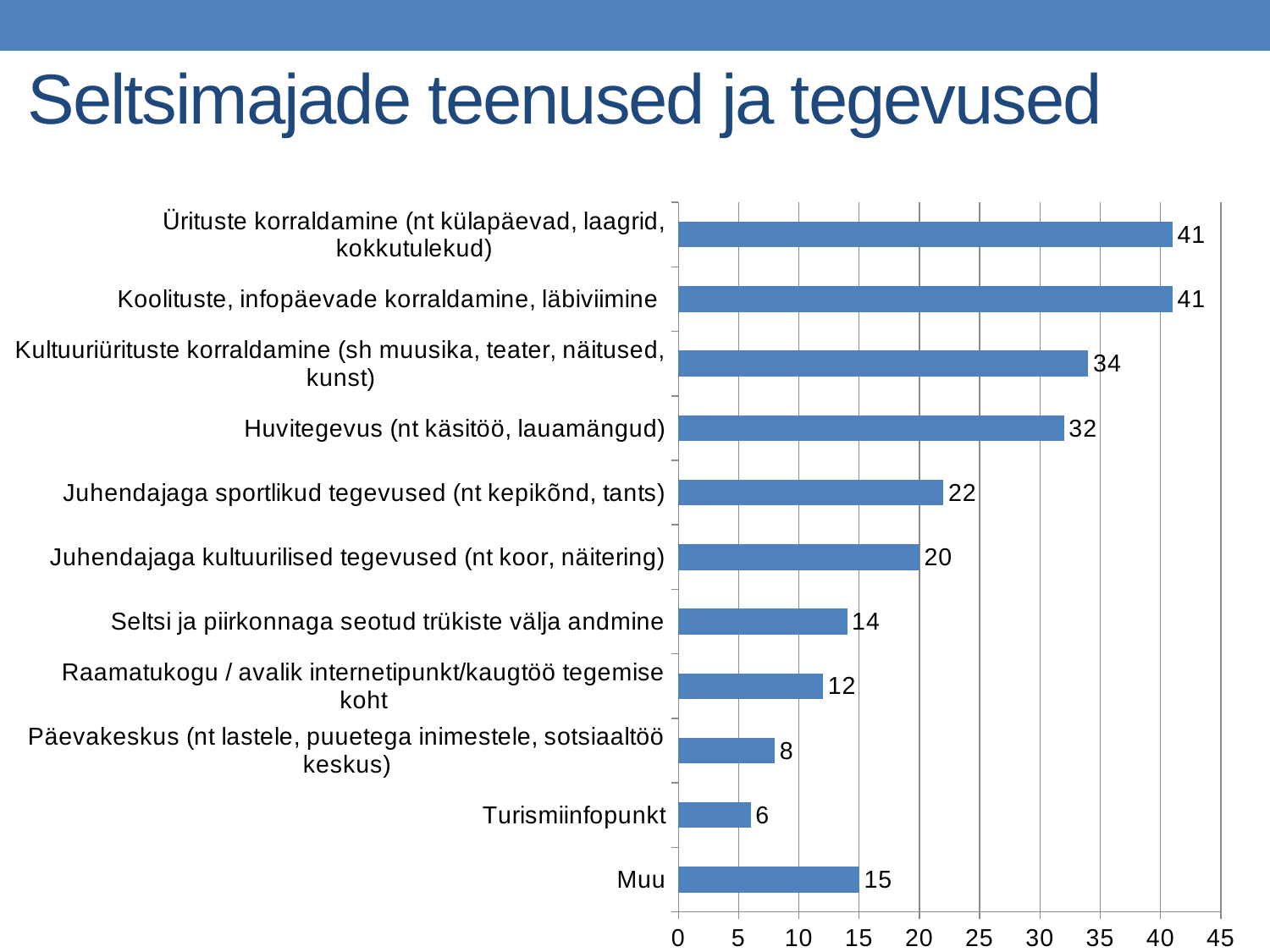
Which is larger: the value for Seltsi ja piirkonnaga seotud trükiste välja andmine or the value for Raamatukogu / avalik internetipunkt/kaugtöö tegemise koht? Seltsi ja piirkonnaga seotud trükiste välja andmine What is the value for Huvitegevus (nt käsitöö, lauamängud)? 32 How many categories are shown in the chart? 11 What is the difference between the values for Kultuuriürituste korraldamine (sh muusika, teater, näitused, kunst) and Huvitegevus (nt käsitöö, lauamängud)? 2 Which category has the lowest value? Turismiinfopunkt What is the value for Muu? 15 What is the value for Turismiinfopunkt? 6 What is the difference between the values for Koolituste, infopäevade korraldamine, läbiviimine and Muu? 26 What kind of chart is shown on the slide? bar chart Is the value for Juhendajaga kultuurilised tegevused (nt koor, näitering) greater or less than 25? less What is the title of the slide? Seltsimajade teenused ja tegevused What is the value for Juhendajaga sportlikud tegevused (nt kepikõnd, tants)? 22